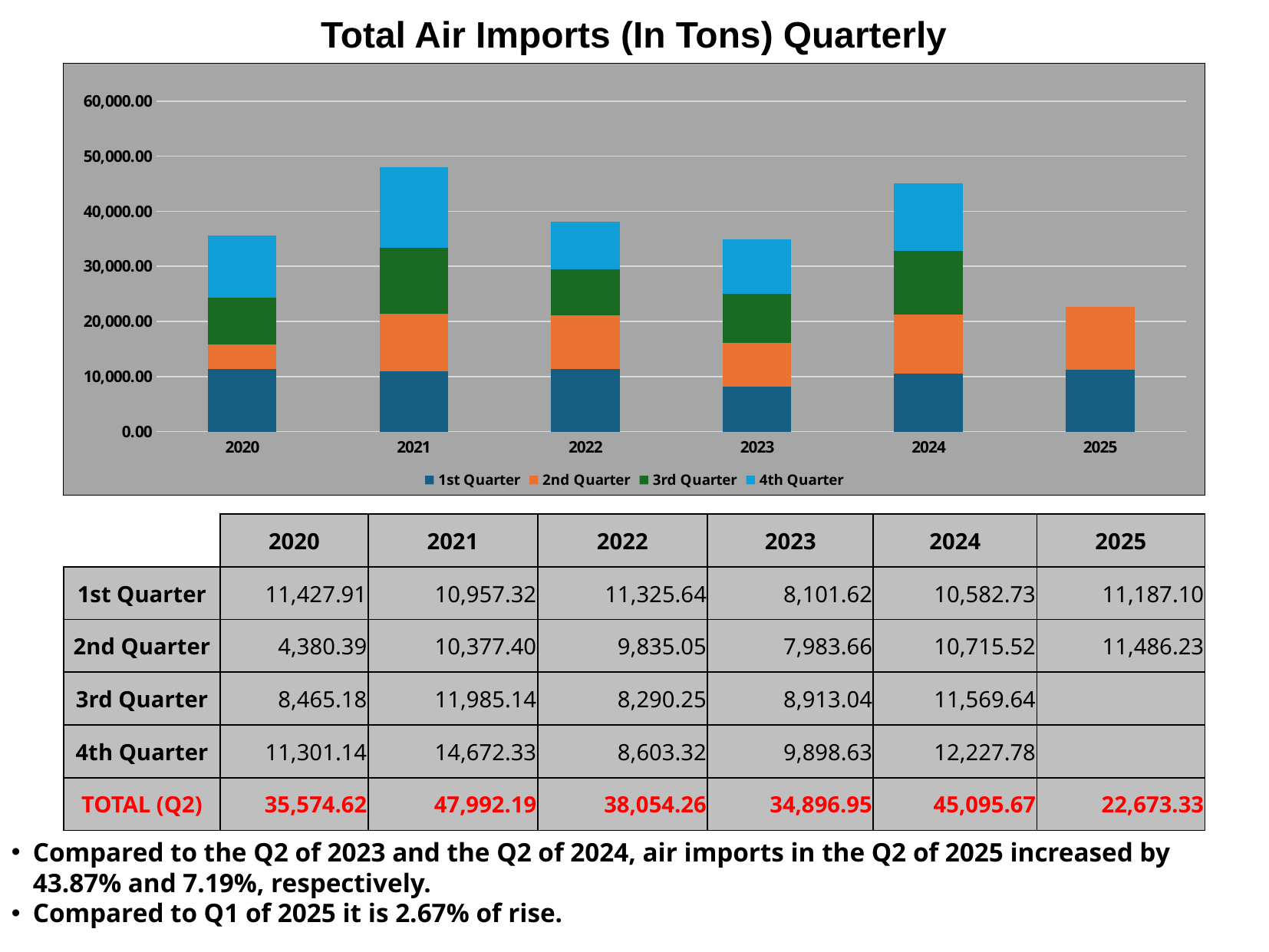
What is the difference between the 1st Quarter value for 2020 and the 1st Quarter value for 2023? 3,326.29 What is the title of the chart? Total Air Imports (In Tons) Quarterly Which year has the shortest stacked bar in the chart? 2025 Which year has the tallest stacked bar in the chart? 2021 What kind of chart is shown on the slide? Stacked bar chart Which is larger, the 4th Quarter value for 2021 or the 4th Quarter value for 2022? 2021 What is the total of the stacked bar for 2023? 34,896.95 How many years are shown along the x axis of the chart? 6 Is the total height of the stacked bar for 2024 greater or less than 40,000.00? greater How many series does the legend of the chart list? 4 What is the 2nd Quarter value for 2021? 10,377.40 What is the 4th Quarter value for 2024? 12,227.78